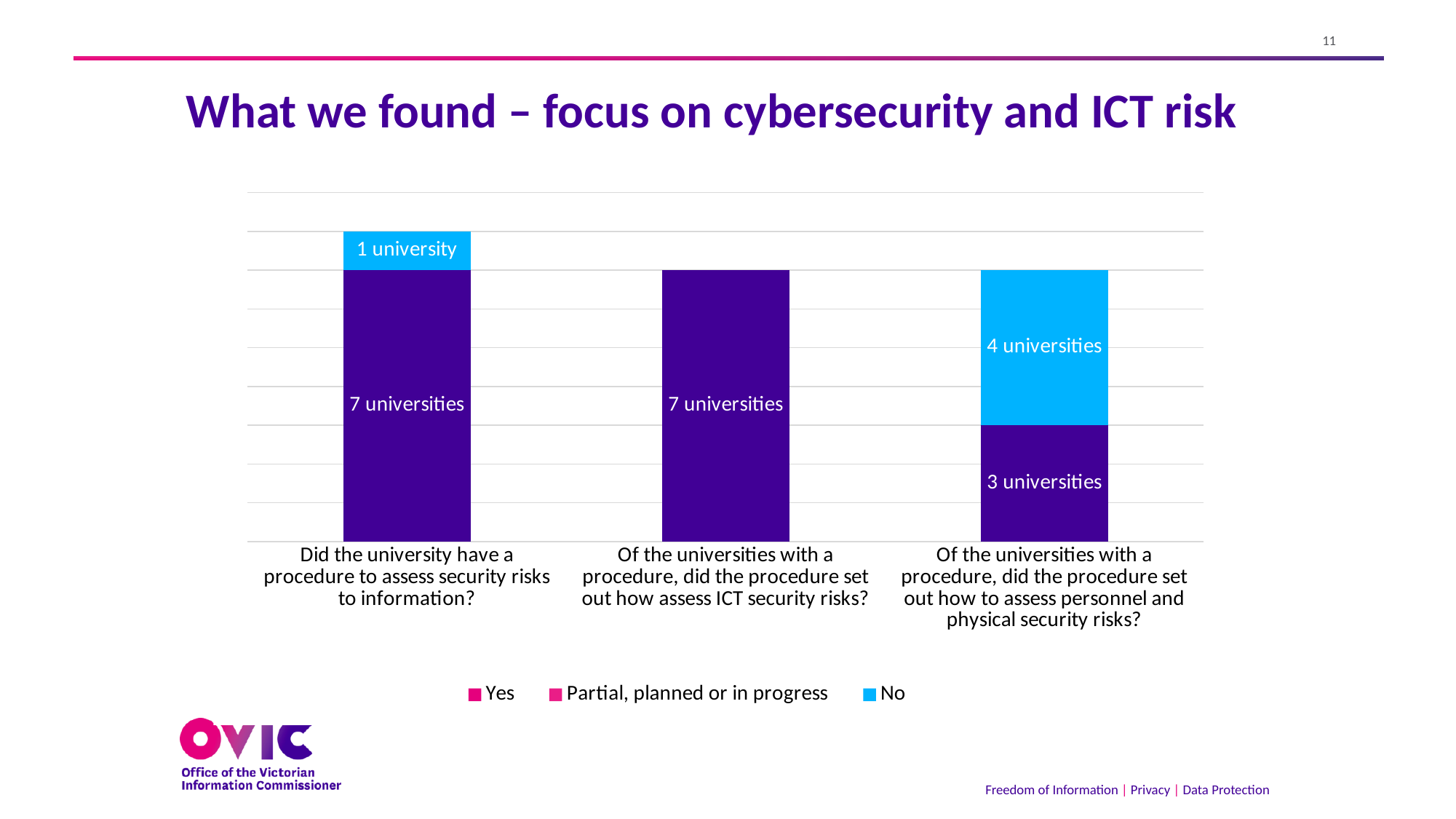
What is the data label on the blue (No) segment of the bar for 'Did the university have a procedure to assess security risks to information?' 1 university In the bar for personnel and physical security risks, what is the difference between the blue (No) segment and the purple segment? 1 university What is the data label on the purple segment of the bar for 'Of the universities with a procedure, did the procedure set out how to assess personnel and physical security risks?' 3 universities What is the data label on the purple segment of the bar for 'Of the universities with a procedure, did the procedure set out how assess ICT security risks?' 7 universities Which question category has the tallest stacked bar overall? Did the university have a procedure to assess security risks to information? What is the data label on the blue (No) segment of the bar for 'Of the universities with a procedure, did the procedure set out how to assess personnel and physical security risks?' 4 universities What is the total number of universities in the stacked bar for 'Did the university have a procedure to assess security risks to information?' 8 universities How many question categories are shown along the x axis of the chart? 3 In the bar for personnel and physical security risks, which segment is larger: the blue (No) segment or the purple segment? The blue (No) segment What are the three entries listed in the chart legend? Yes; Partial, planned or in progress; No What kind of chart is shown on the slide? Stacked bar chart How many series does the chart legend list? 3